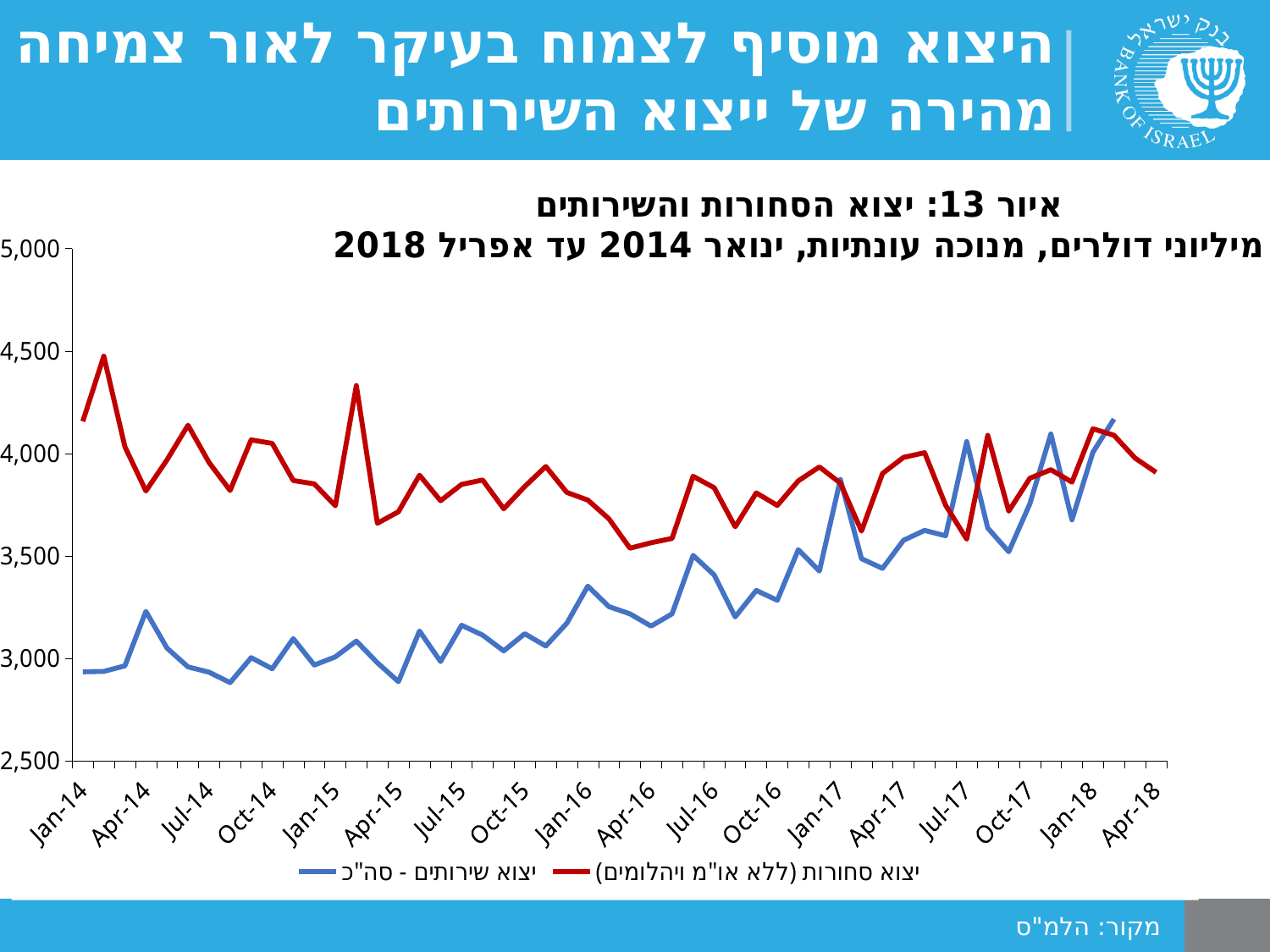
Is the value of the blue series (יצוא שירותים) at Jan-14 greater or less than 3,500? less Is the value of the red series (יצוא סחורות) at Apr-15 greater or less than 4,000? less How many series does the legend list? 2 Does the blue series (יצוא שירותים - סה"כ) generally rise or fall from Jan-14 to Apr-18? rise What are the two series named in the legend? יצוא סחורות (ללא או"מ ויהלומים) and יצוא שירותים - סה"כ Is the value of the red series (יצוא סחורות) at Jan-14 greater or less than 4,000? greater At Jan-14, which series is higher: the red goods exports line or the blue services exports line? the red goods exports line What kind of chart is shown on the slide? line chart How many date labels are shown along the x axis? 18 What is the title of the chart? איור 13: יצוא הסחורות והשירותים